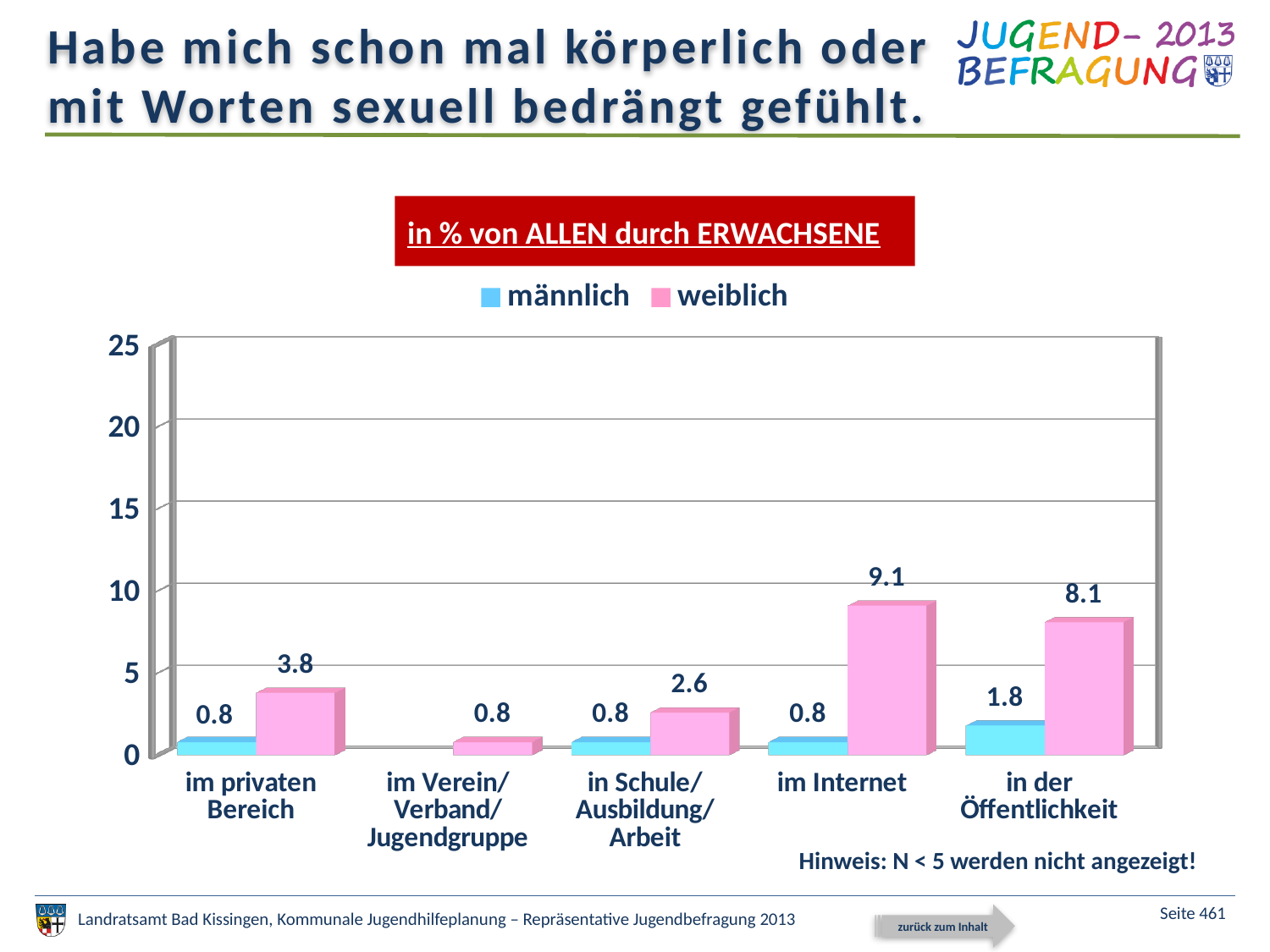
Which category has the lowest value for weiblich? im Verein/Verband/Jugendgruppe Which category has the highest value for weiblich? im Internet How many series does the legend list? 2 What is the value for weiblich in the category 'im Internet'? 9.1 What is the value for weiblich in the category 'im privaten Bereich'? 3.8 What is the difference between the weiblich and männlich values for 'im privaten Bereich'? 3.0 What is the value for weiblich in the category 'in Schule/Ausbildung/Arbeit'? 2.6 Which is larger: the männlich value for 'in der Öffentlichkeit' or the männlich value for 'im Internet'? in der Öffentlichkeit How many categories are shown on the x axis? 5 What is the value for männlich in the category 'in der Öffentlichkeit'? 1.8 What kind of chart is shown on the slide? bar chart What is the difference between the weiblich values for 'im Internet' and 'in der Öffentlichkeit'? 1.0